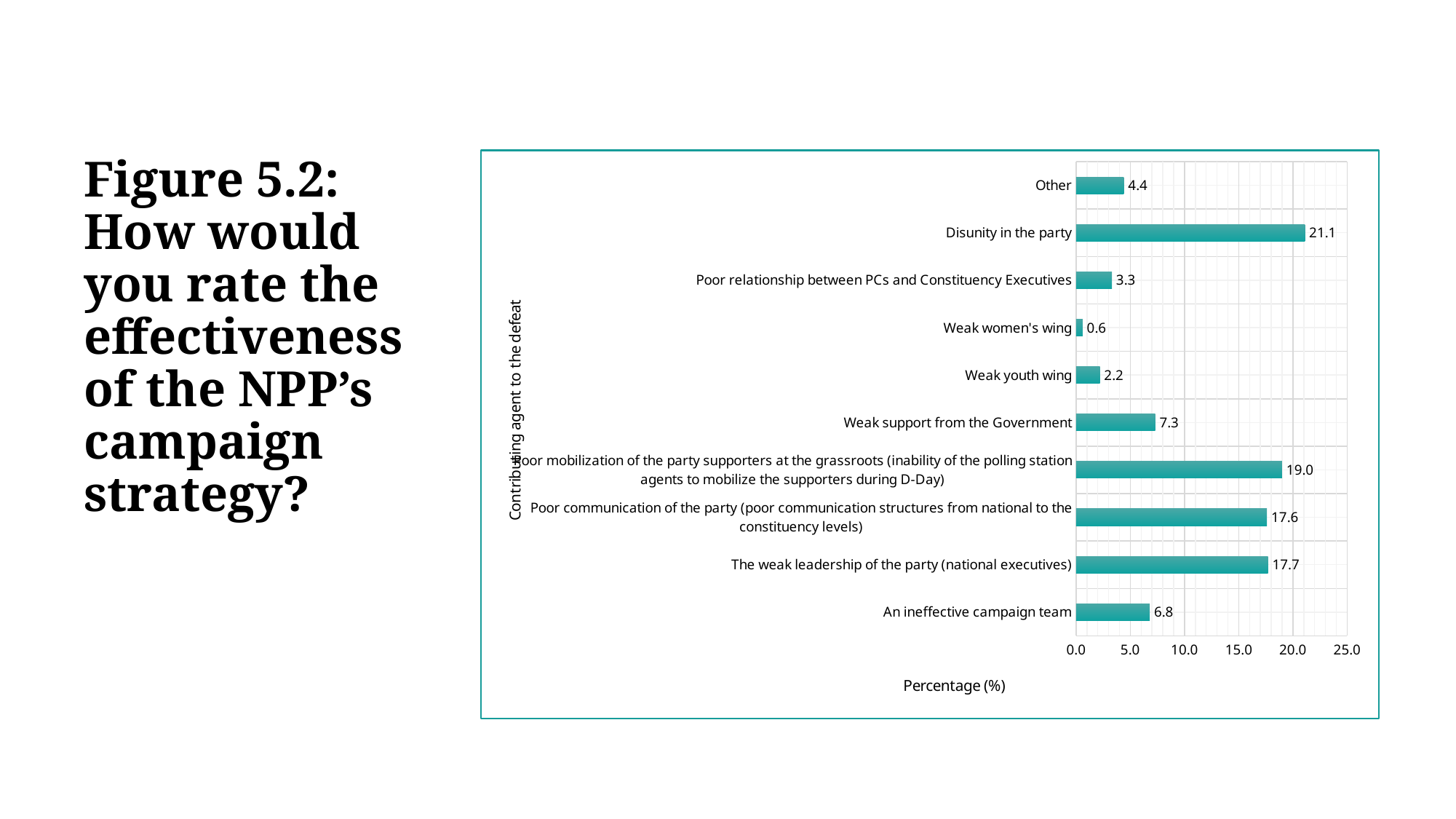
Which category has the highest value? Disunity in the party What is the value for An ineffective campaign team? 6.8 How many categories are shown on the chart? 10 Which is larger, the value for Weak support from the Government or the value for An ineffective campaign team? Weak support from the Government What is the difference between the values for Disunity in the party and Other? 16.7 Which category has the lowest value? Weak women's wing Is the value for Poor mobilization of the party supporters at the grassroots greater or less than 15.0? greater What is the label of the horizontal axis? Percentage (%) What kind of chart is shown on the slide? bar chart What is the value for Weak support from the Government? 7.3 What is the value for Weak youth wing? 2.2 What is the value for Disunity in the party? 21.1